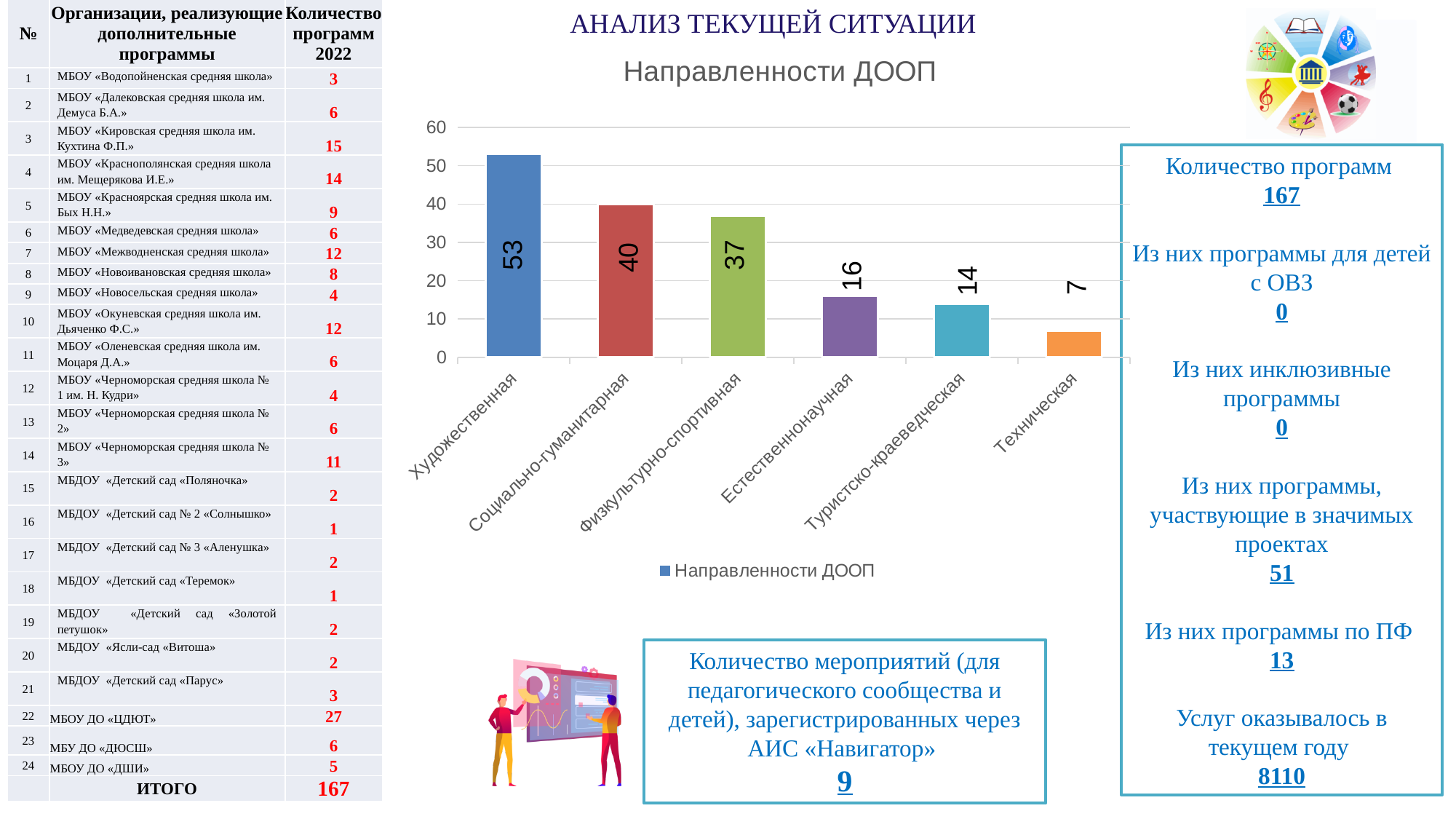
Which is larger, the value for Физкультурно-спортивная or the value for Естественнонаучная? Физкультурно-спортивная How many series does the legend list? 1 What is the difference between the values for Естественнонаучная and Техническая? 9 What is the value for Художественная? 53 What is the value for Социально-гуманитарная? 40 Do the values rise or fall from left to right along the x axis? fall How many categories are shown on the x axis of the chart? 6 What is the difference between the values for Художественная and Социально-гуманитарная? 13 What is the value for Туристско-краеведческая? 14 Which category has the lowest value? Техническая What type of chart is shown on the slide? bar chart Which category has the highest value? Художественная